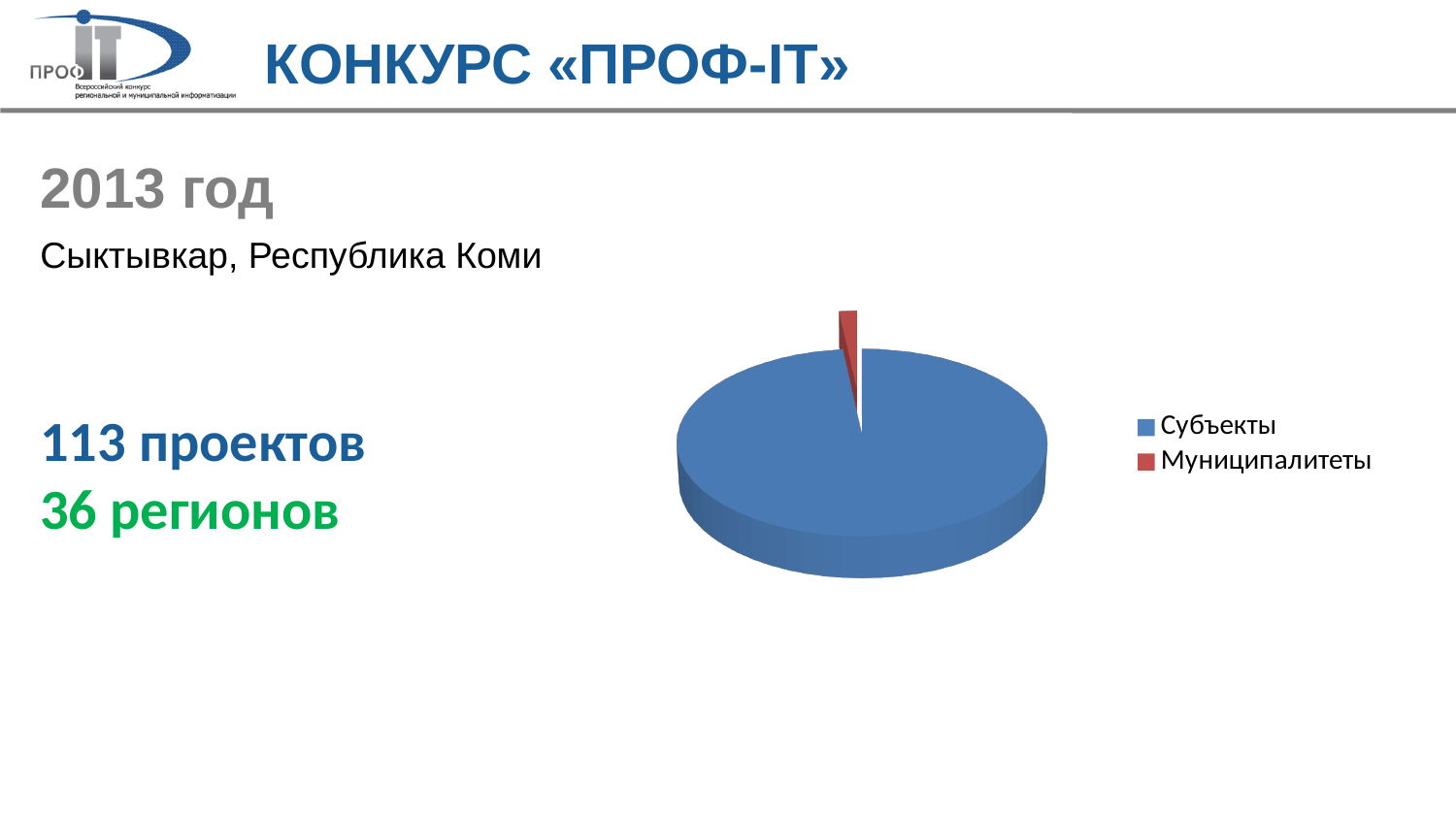
What colour is the Муниципалитеты slice in the pie chart? red Which category has the smallest slice in the pie chart? Муниципалитеты How many entries does the legend of the pie chart list? 2 What kind of chart is shown on the slide? pie chart Which category has the largest slice in the pie chart? Субъекты How many slices does the pie chart have? 2 What colour is the Субъекты slice in the pie chart? blue Which slice is larger in the pie chart, Субъекты or Муниципалитеты? Субъекты